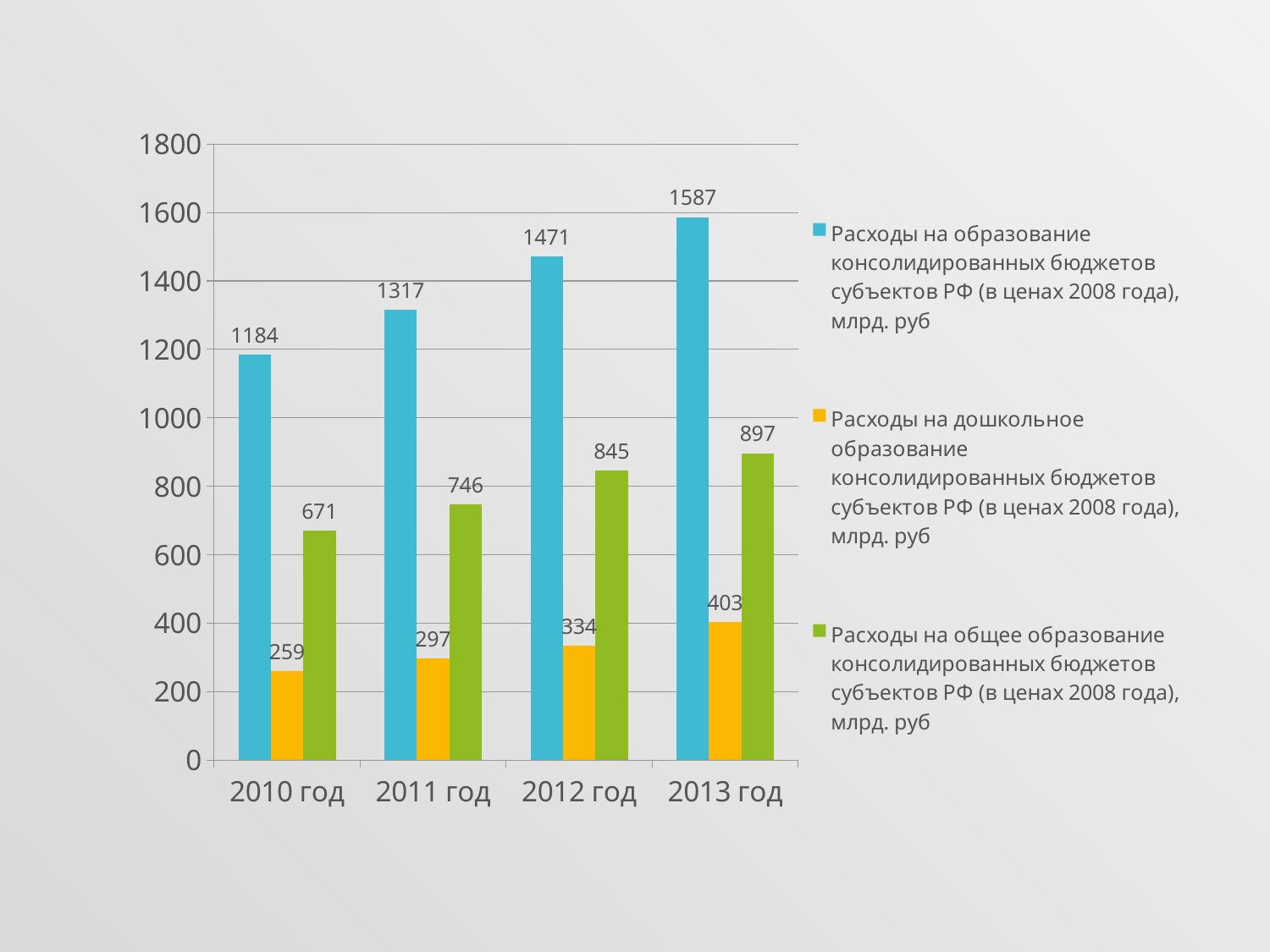
Does preschool education expenditure rise or fall from 2010 год to 2013 год? Rises Which is larger: general education expenditure in 2011 год or preschool education expenditure in 2013 год? General education expenditure in 2011 год (746) What is the value of total education expenditure (Расходы на образование) for 2012 год? 1471 Is the value of general education expenditure for 2012 год greater or less than 800? greater What kind of chart is shown on the slide? Bar chart How many years are shown on the x axis? 4 What is the value of general education expenditure (Расходы на общее образование) for 2013 год? 897 In which year is preschool education expenditure (Расходы на дошкольное образование) lowest? 2010 год How many series does the legend list? 3 What is the value of preschool education expenditure (Расходы на дошкольное образование) for 2010 год? 259 What is the difference between total education expenditure in 2013 год and 2010 год? 403 In which year is total education expenditure (Расходы на образование) highest? 2013 год